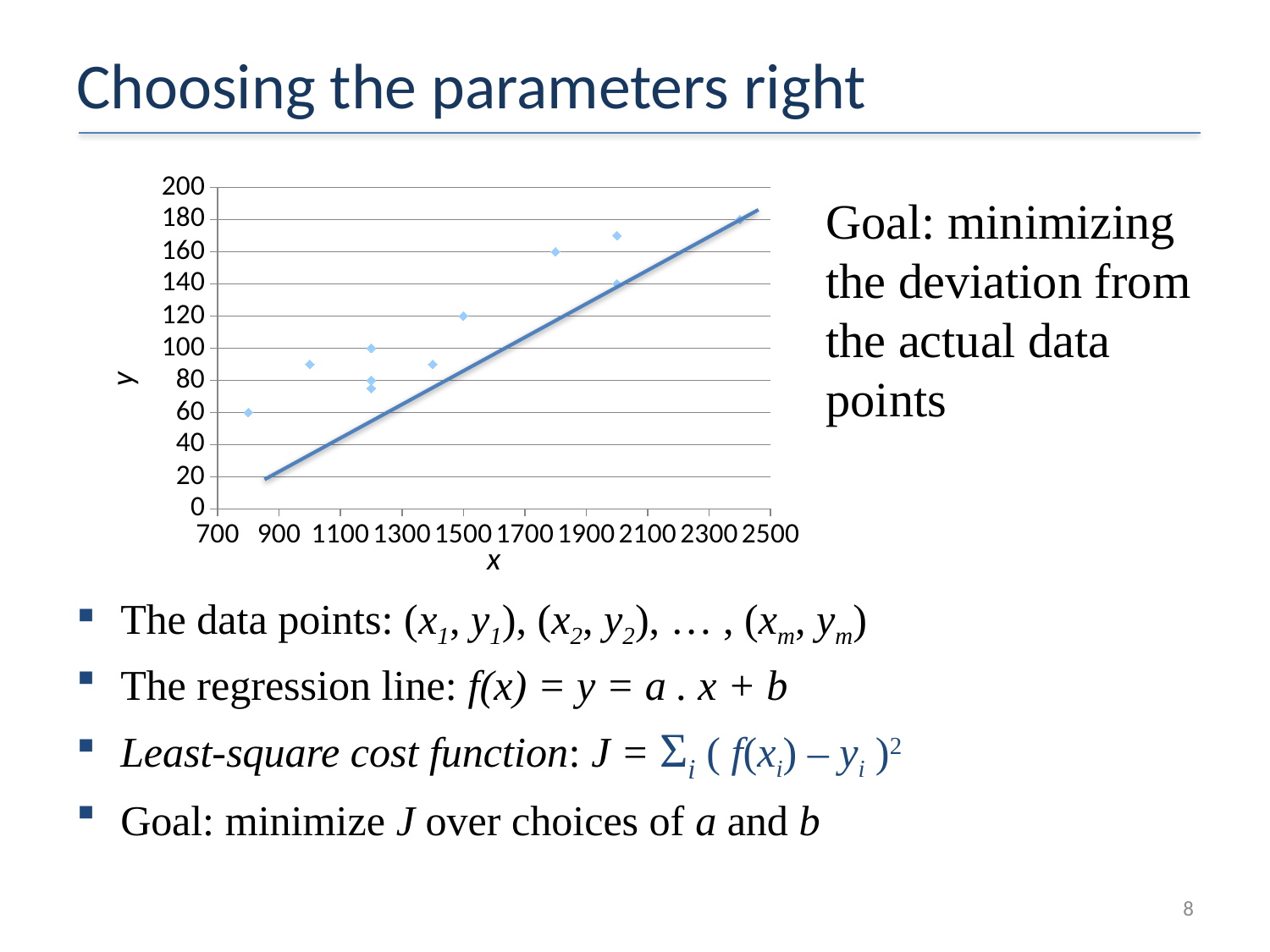
What kind of chart is shown on the slide? scatter chart Is the y value of the data point at x = 1800 greater or less than 140? greater What is the label of the horizontal axis of the chart? x Which data point has the lowest y value: the one at x = 800 or the one at x = 1800? the one at x = 800 What is the highest value shown on the vertical axis of the chart? 200 Is the y value of the regression line at its left end (near x = 900) greater or less than 40? less Is the y value of the data point at x = 1500 greater or less than 100? greater Do the plotted data points generally rise or fall as x increases? rise What is the label of the vertical axis of the chart? y